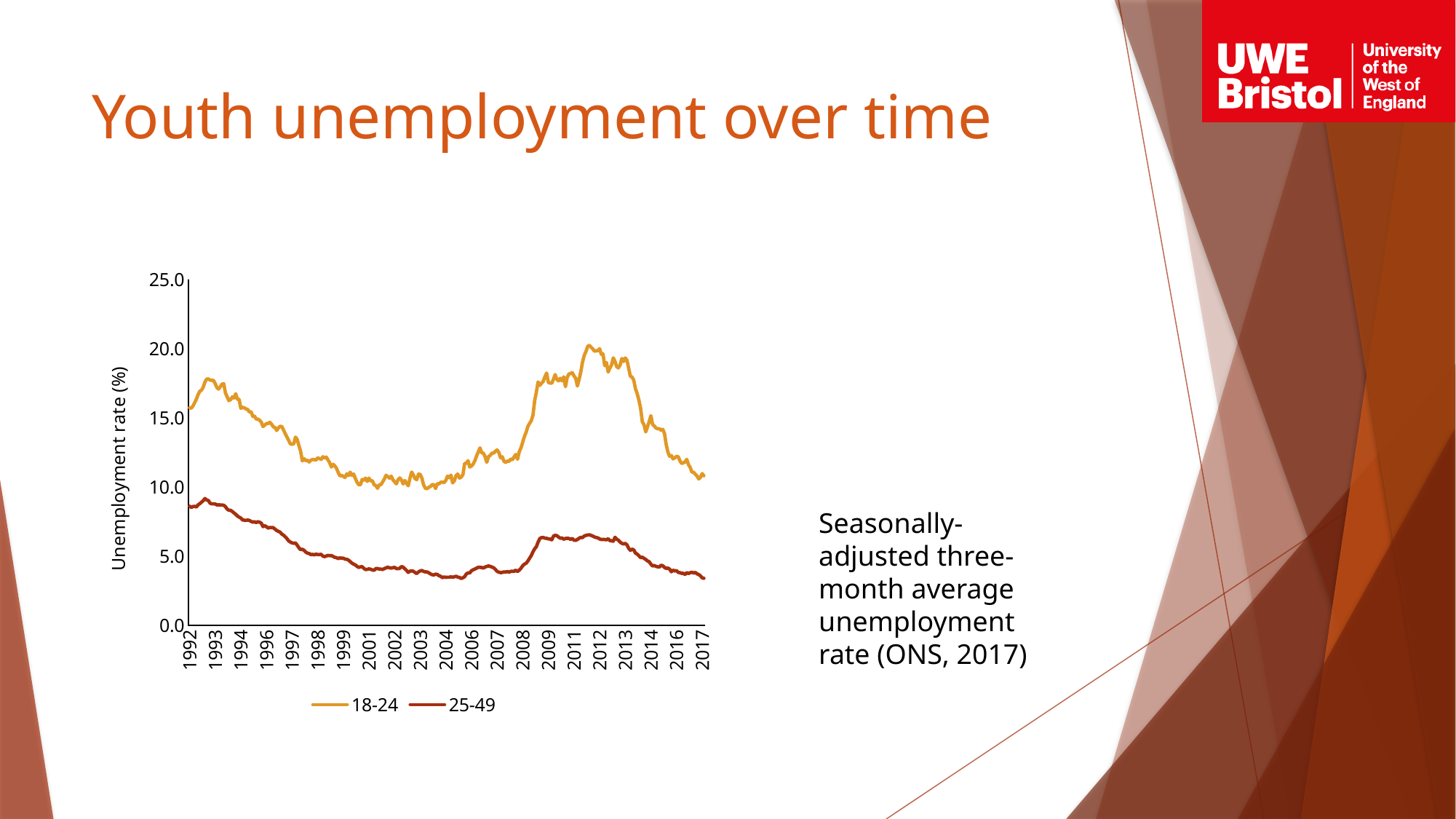
Which series has the higher unemployment rate across the whole period, 18-24 or 25-49? 18-24 What are the two series named in the chart's legend? 18-24 and 25-49 Is the unemployment rate for the 25-49 series in 2017 greater or less than 5.0? less How many series does the chart's legend list? 2 What is the label on the chart's vertical axis? Unemployment rate (%) Does the unemployment rate for the 18-24 series rise or fall between 2008 and 2011? rise Is the unemployment rate for the 25-49 series in 1992 greater or less than 5.0? greater Is the unemployment rate for the 18-24 series in 2003 greater or less than 15.0? less Does the unemployment rate for the 18-24 series rise or fall between 1993 and 2003? fall What kind of chart is shown on the slide? line chart Does the unemployment rate for the 25-49 series rise or fall between 2013 and 2017? fall